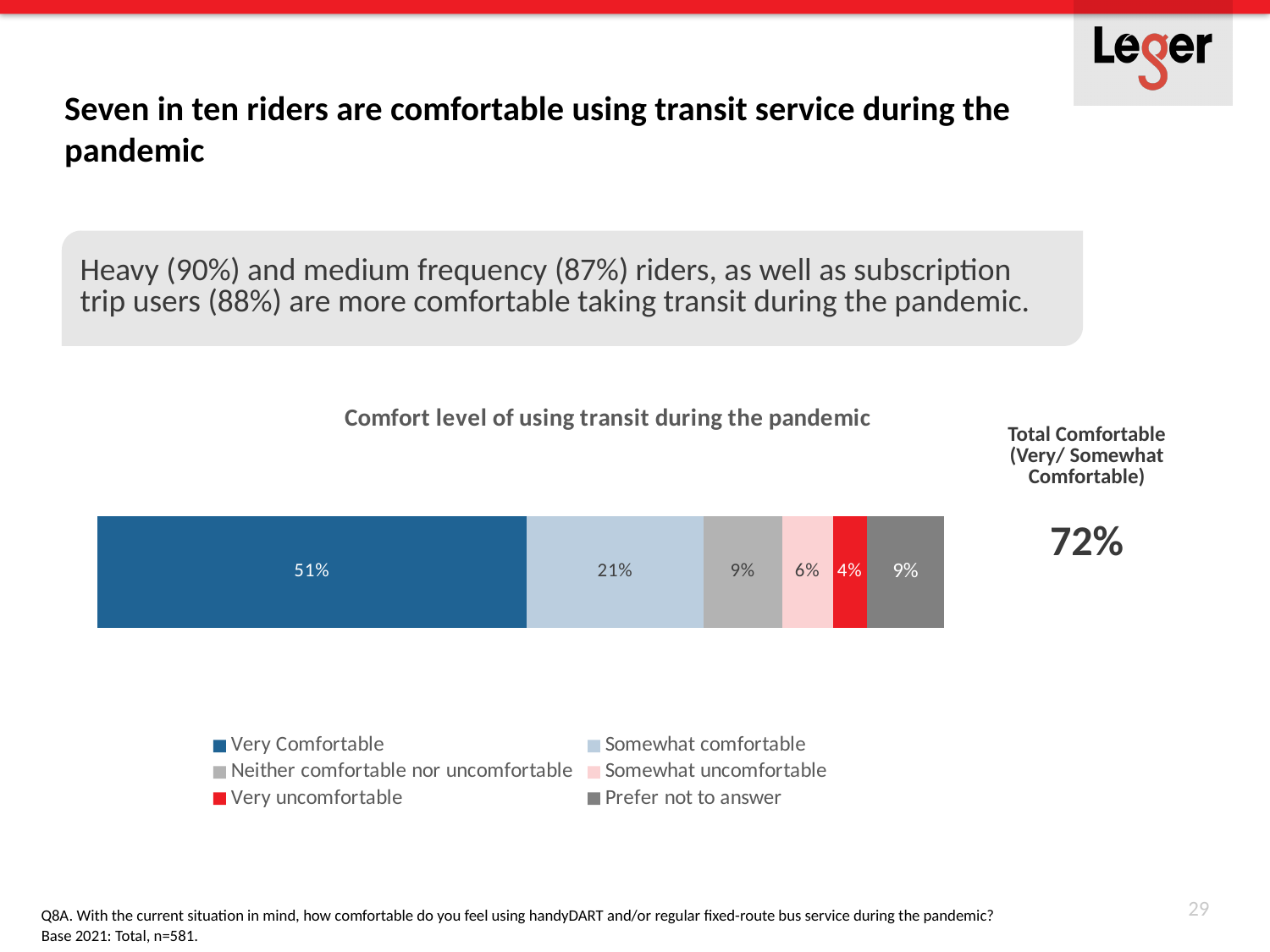
What is the difference between the Very Comfortable and Somewhat comfortable percentages? 30% What percentage of riders are Very uncomfortable? 4% What percentage of riders are Very Comfortable using transit during the pandemic? 51% What percentage of riders are Somewhat comfortable? 21% How many series does the legend list? 6 What is the Total Comfortable (Very/Somewhat Comfortable) percentage shown next to the chart? 72% Which response category has the smallest share of riders? Very uncomfortable What is the title of the chart? Comfort level of using transit during the pandemic Which is larger: the share of Somewhat uncomfortable riders or the share of Very uncomfortable riders? Somewhat uncomfortable Which response category has the largest share of riders? Very Comfortable What percentage of riders chose Prefer not to answer? 9% What kind of chart is shown on the slide? Stacked bar chart